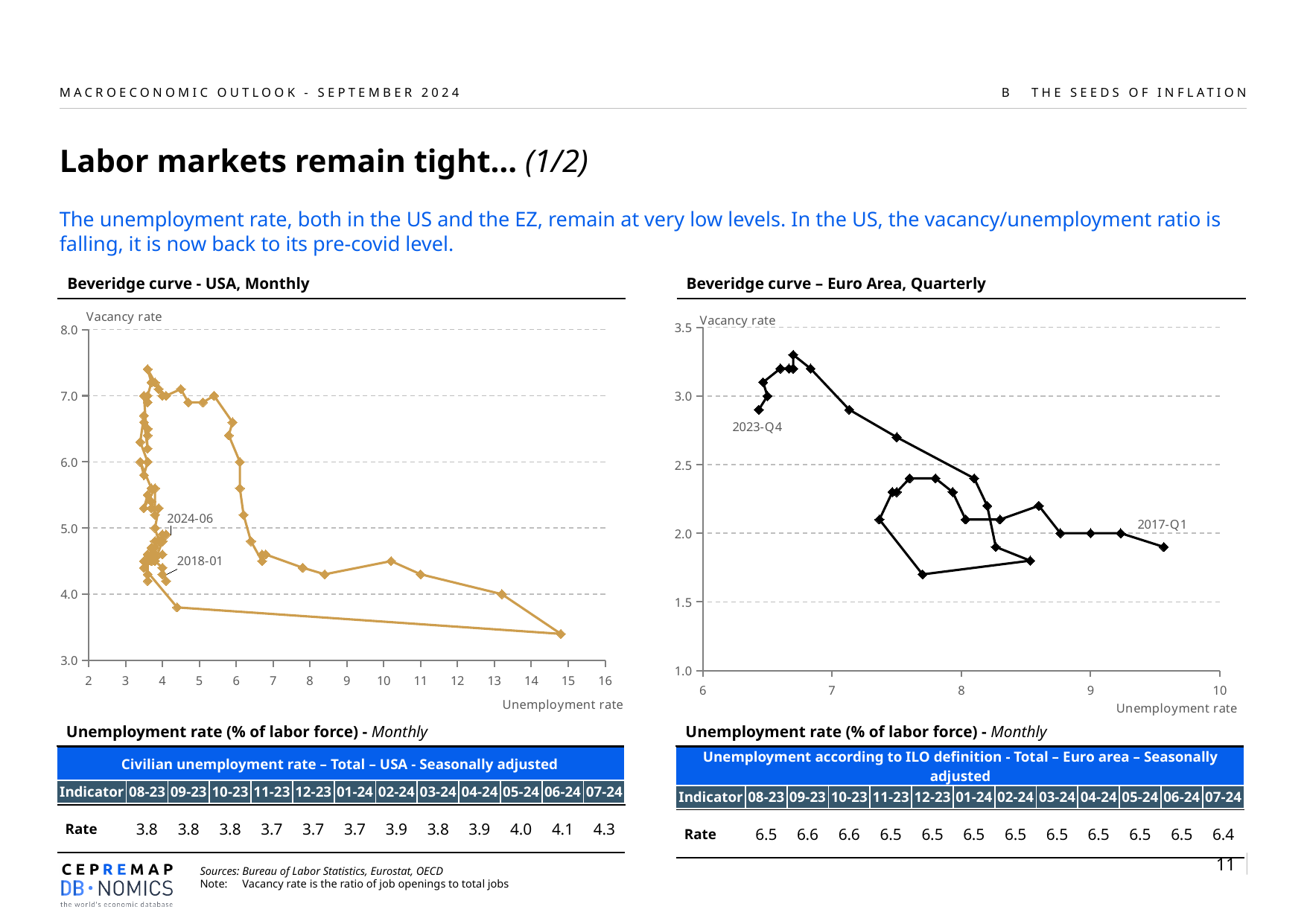
In the 'Beveridge curve – Euro Area, Quarterly' chart, is the unemployment rate at the point labelled 2023-Q4 greater or less than 7? less In the 'Beveridge curve – Euro Area, Quarterly' chart, is the vacancy rate at the point labelled 2017-Q1 greater or less than 2.5? less In the 'Beveridge curve - USA, Monthly' chart, is the vacancy rate at the point with the highest unemployment rate greater or less than 4.0? less In the 'Beveridge curve – Euro Area, Quarterly' chart, which point has the higher unemployment rate, 2017-Q1 or 2023-Q4? 2017-Q1 What kind of chart is the 'Beveridge curve - USA, Monthly' chart? line chart In the 'Beveridge curve - USA, Monthly' chart, what is the label of the vertical axis? Vacancy rate What is the title of the chart on the right side of the slide? Beveridge curve – Euro Area, Quarterly In the 'Beveridge curve - USA, Monthly' chart, which point has the higher vacancy rate, 2024-06 or 2018-01? 2024-06